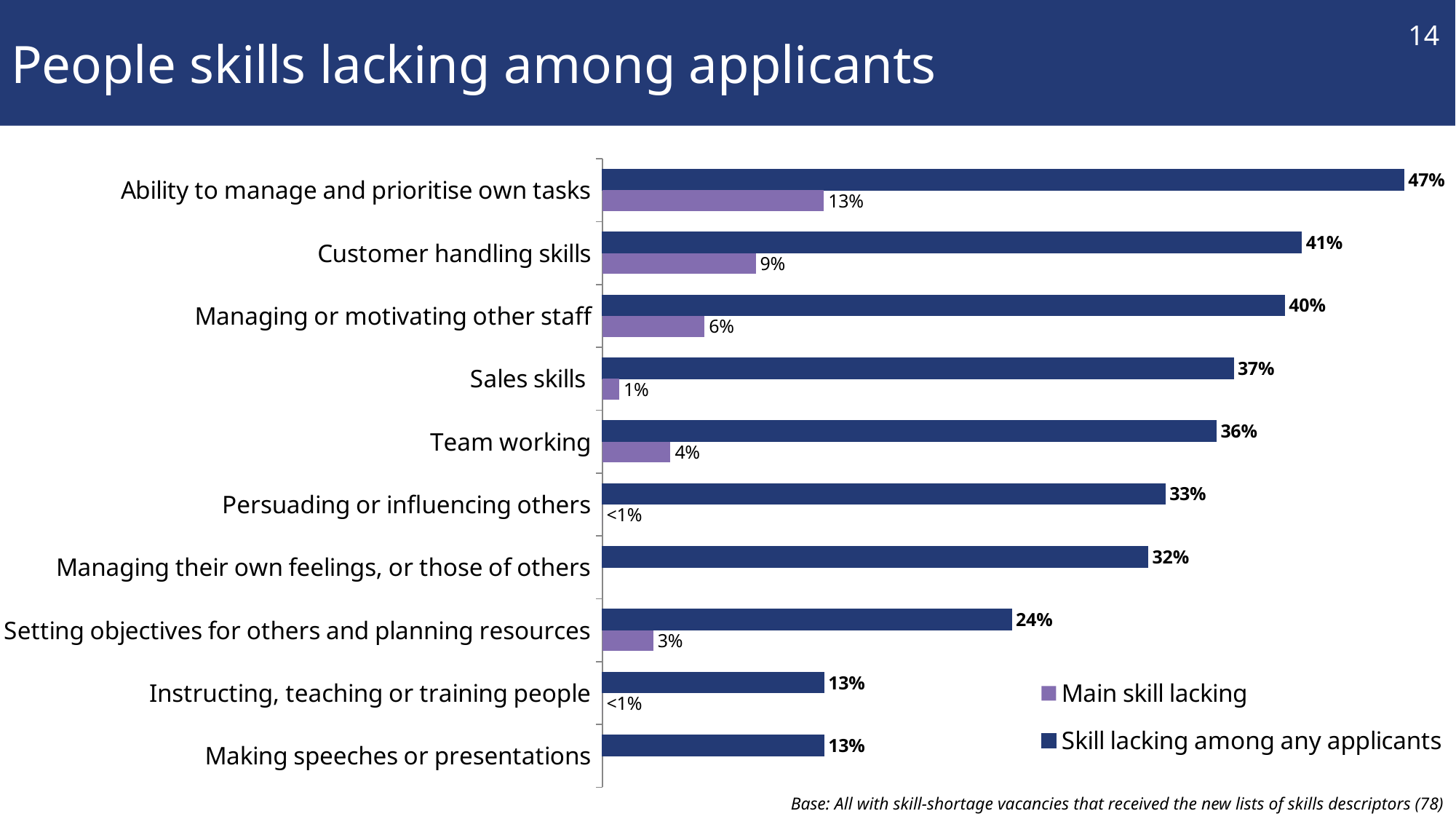
What is the value for 'Main skill lacking' for Customer handling skills? 9% What colour are the bars for the 'Main skill lacking' series? Purple What is the value for 'Skill lacking among any applicants' for Ability to manage and prioritise own tasks? 47% How many categories are shown on the chart? 10 Which category has the highest value for 'Skill lacking among any applicants'? Ability to manage and prioritise own tasks Which category has the highest value for 'Main skill lacking'? Ability to manage and prioritise own tasks What is the difference between the 'Skill lacking among any applicants' values for Customer handling skills and Team working? 5% Which is larger for 'Main skill lacking': Managing or motivating other staff or Team working? Managing or motivating other staff What is the value for 'Main skill lacking' for Sales skills? 1% What kind of chart is shown on the slide? Bar chart What is the value for 'Skill lacking among any applicants' for Setting objectives for others and planning resources? 24% How many series does the legend list? 2